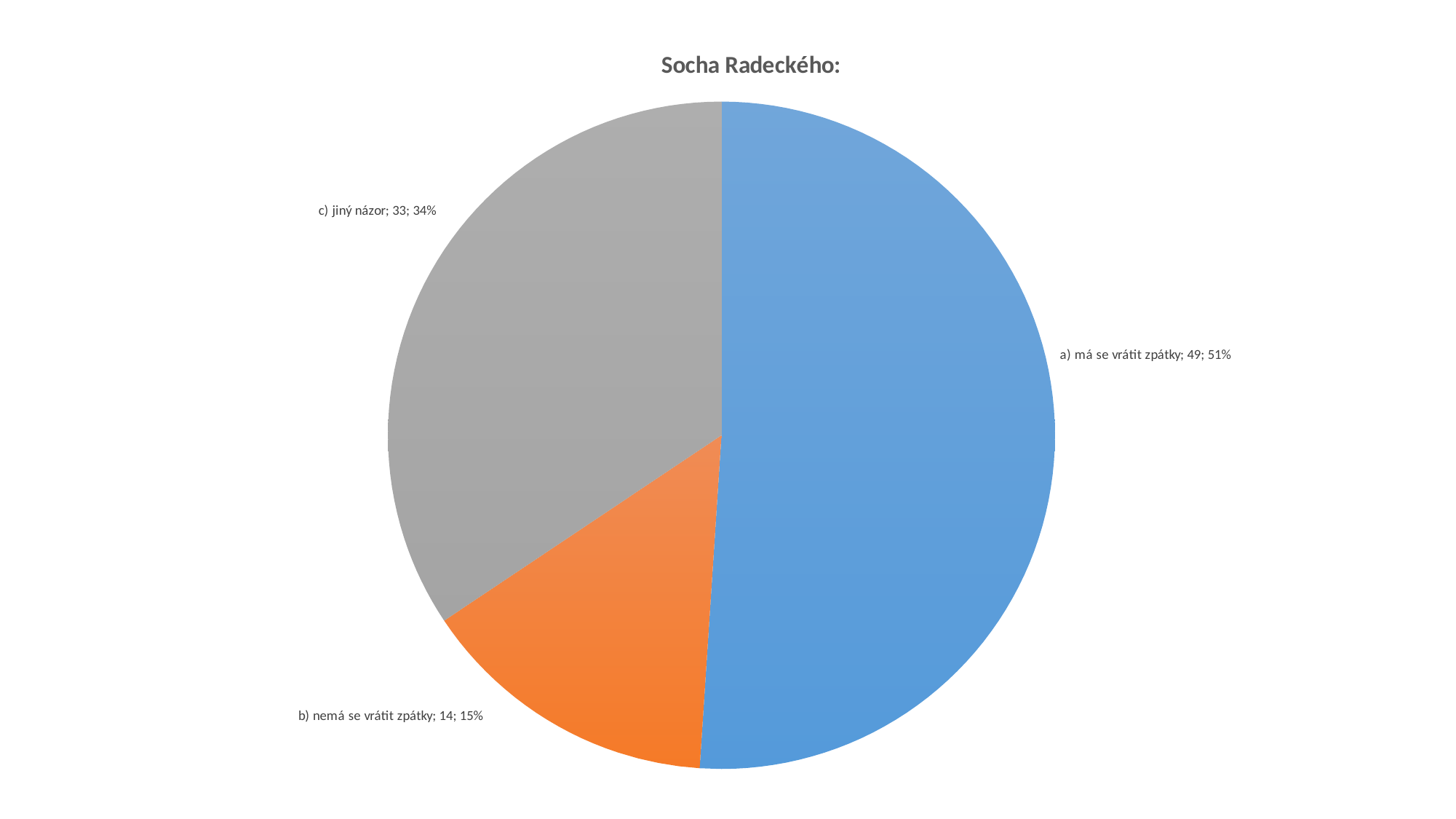
Which category has the largest slice? a) má se vrátit zpátky What is the title of the chart? Socha Radeckého: What is the value for "b) nemá se vrátit zpátky"? 14 What share of the pie does "c) jiný názor" represent? 34% How many slices does the pie chart have? 3 Which is larger, the value for "c) jiný názor" or the value for "b) nemá se vrátit zpátky"? c) jiný názor What is the difference between the values for "a) má se vrátit zpátky" and "c) jiný názor"? 16 What is the value for "c) jiný názor"? 33 What kind of chart is shown on the slide? pie chart What share of the pie does "b) nemá se vrátit zpátky" represent? 15% Which category has the smallest slice? b) nemá se vrátit zpátky What is the value for "a) má se vrátit zpátky"? 49